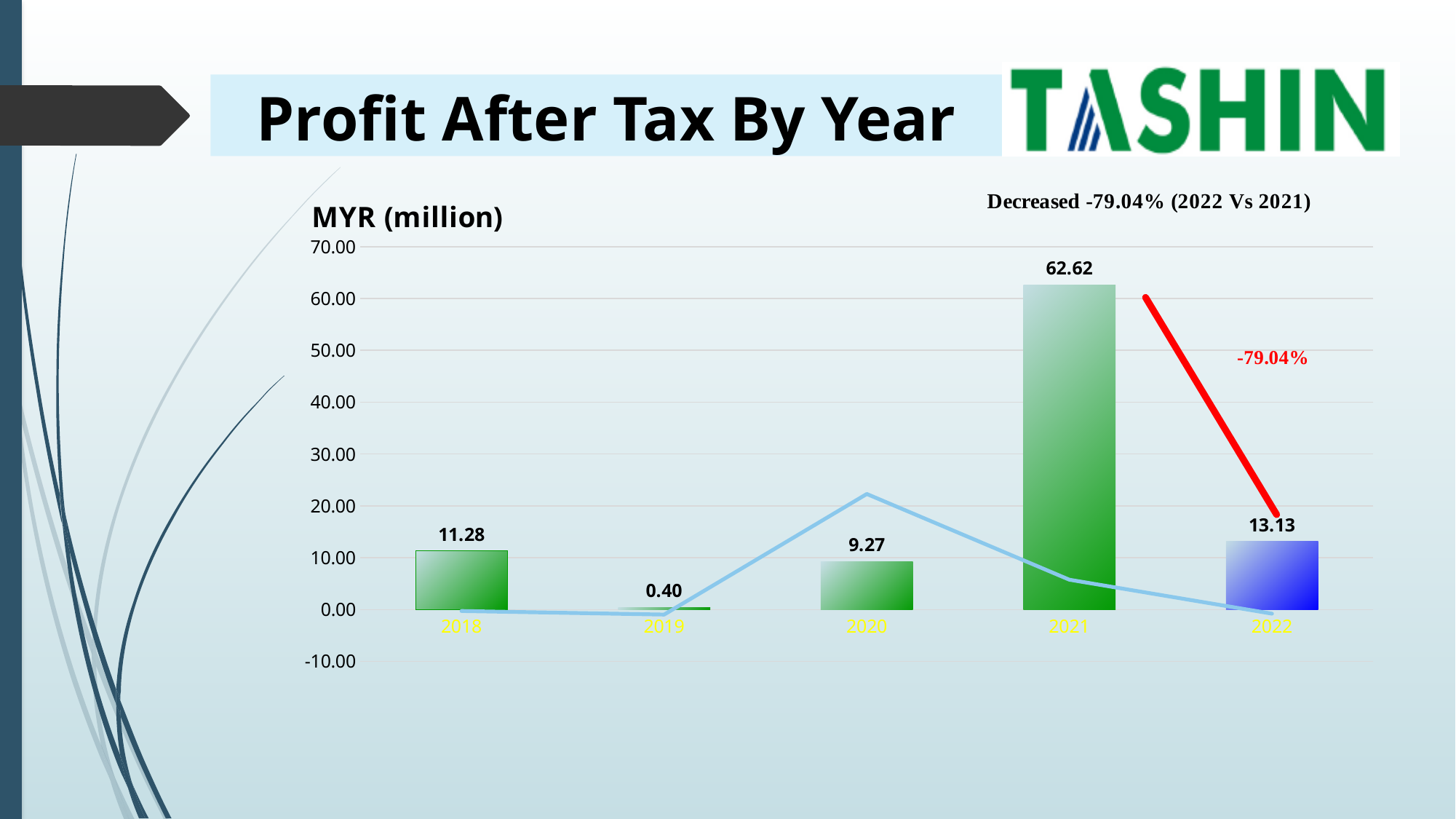
Which year has the lowest profit after tax bar? 2019 What kind of chart is used to show profit after tax by year? bar chart What is the profit after tax value shown for 2022? 13.13 What is the profit after tax value shown for 2021? 62.62 Which year has a larger profit after tax bar, 2018 or 2022? 2022 Is the profit after tax bar for 2021 greater or less than 50.00? greater What is the difference between the 2021 and 2022 profit after tax values? 49.49 Which year has the highest profit after tax bar? 2021 What is the profit after tax value shown for 2019? 0.40 How many years are shown on the x axis of the chart? 5 What is the difference between the 2018 and 2020 profit after tax values? 2.01 What percentage change from 2021 to 2022 is annotated on the chart? -79.04%